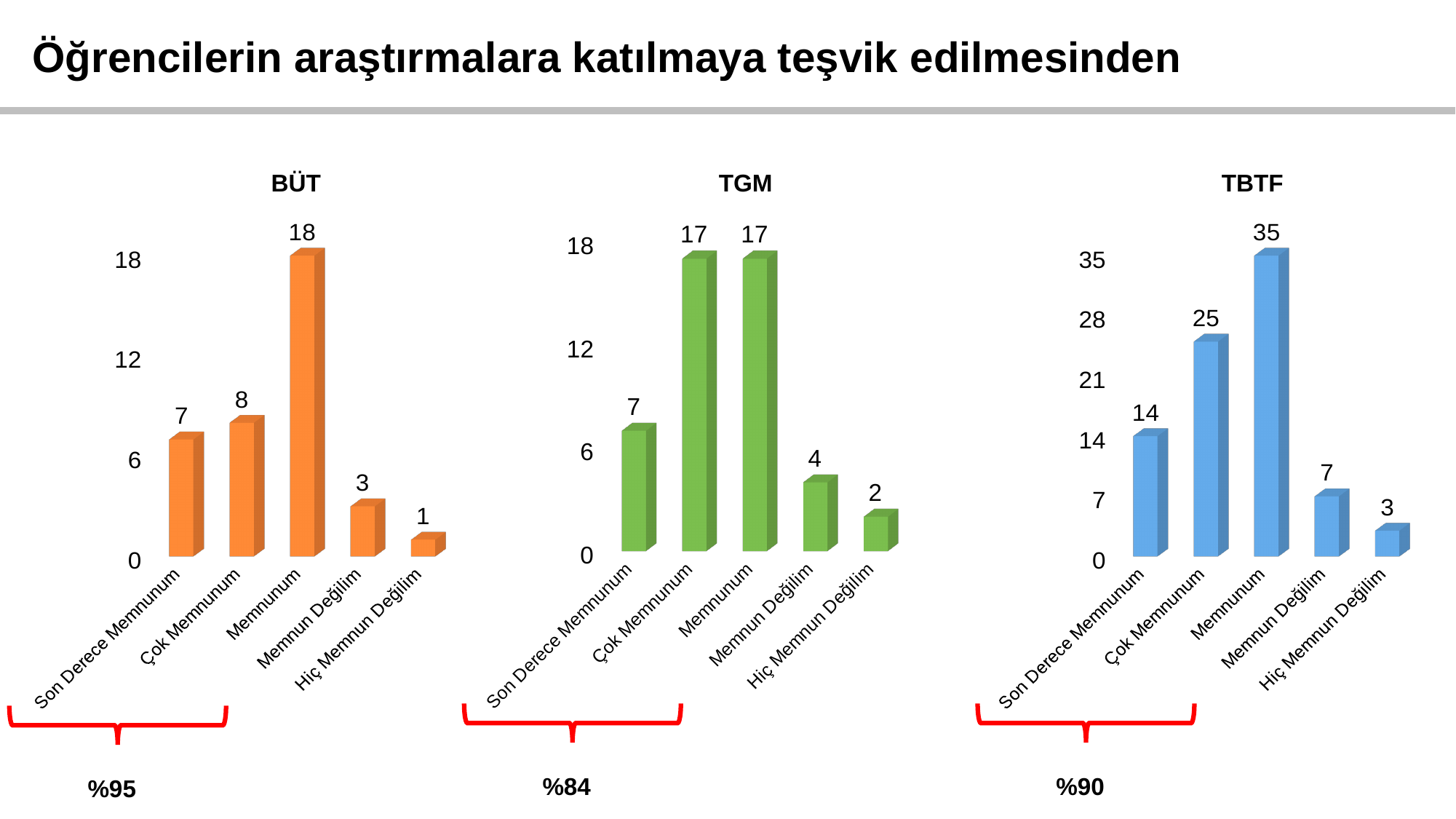
In the TBTF chart, what is the value for Çok Memnunum? 25 In the TGM chart, how many categories are shown? 5 What type of chart is the TGM chart? bar chart In the BÜT chart, which category has the lowest value? Hiç Memnun Değilim In the TGM chart, what is the value for Memnun Değilim? 4 In the TGM chart, what is the difference between Son Derece Memnunum and Hiç Memnun Değilim? 5 What percentage is shown below the bracket under the TBTF chart? %90 What colour are the bars in the BÜT chart? orange In the TBTF chart, what is the difference between Memnunum and Çok Memnunum? 10 In the TBTF chart, which category has the highest value? Memnunum In the BÜT chart, what is the value for Memnunum? 18 In the BÜT chart, which is larger, Son Derece Memnunum or Çok Memnunum? Çok Memnunum